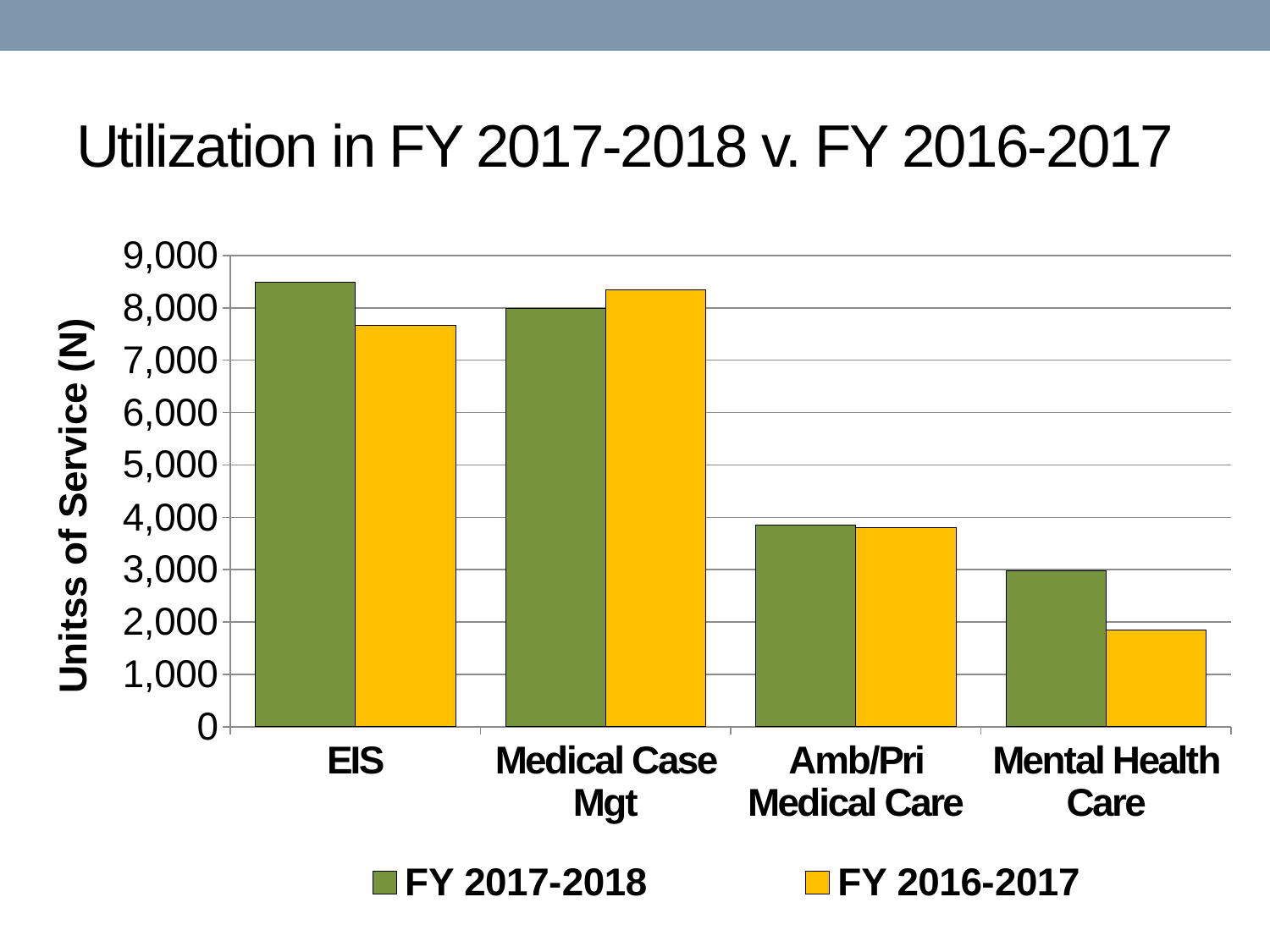
What is the label on the vertical axis of the chart? Unitss of Service (N) For EIS, which fiscal year has the larger value, FY 2017-2018 or FY 2016-2017? FY 2017-2018 For Medical Case Mgt, which fiscal year has the larger value, FY 2017-2018 or FY 2016-2017? FY 2016-2017 Is the value for Mental Health Care in FY 2016-2017 greater or less than 2,000? less Which category has the highest value for FY 2016-2017? Medical Case Mgt How many series does the legend list? 2 Which category has the highest value for FY 2017-2018? EIS What kind of chart is shown on the slide? Bar chart Is the value for Amb/Pri Medical Care in FY 2017-2018 greater or less than 4,000? less How many service categories are shown on the x axis? 4 Which category has the lowest value for FY 2016-2017? Mental Health Care Is the value for EIS in FY 2017-2018 greater or less than 8,000? greater